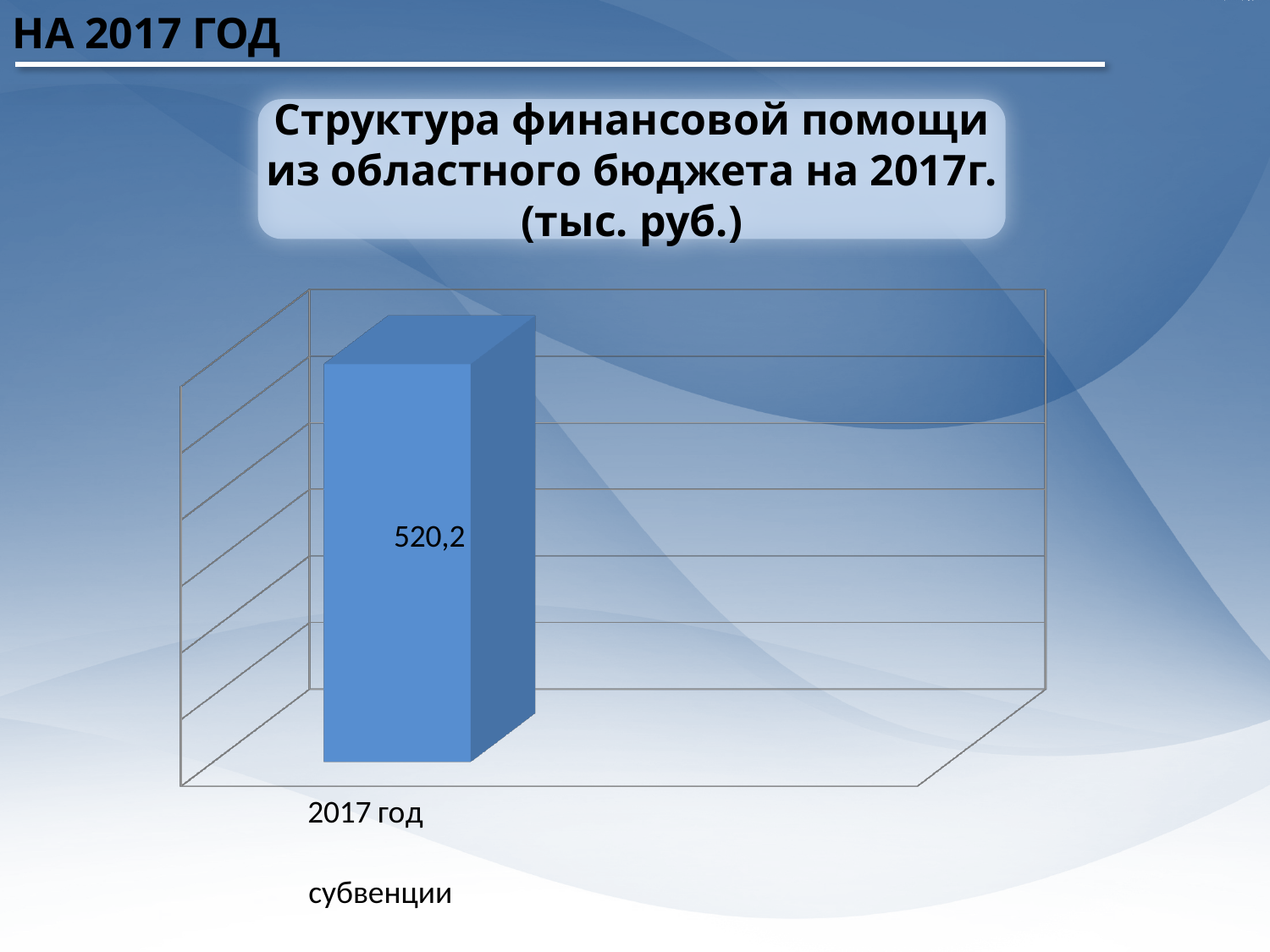
What category label appears under the bar on the x axis? 2017 год What value is shown for субвенции in the chart? 520,2 What kind of chart is shown on the slide? bar chart What is the name of the series shown in the chart legend? субвенции How many series does the chart's legend list? 1 How many categories appear on the x axis of the chart? 1 How many bars are plotted in the chart? 1 What is the value of the bar for 2017 год? 520,2 In what units are the values in the chart expressed, according to the chart title? тыс. руб.